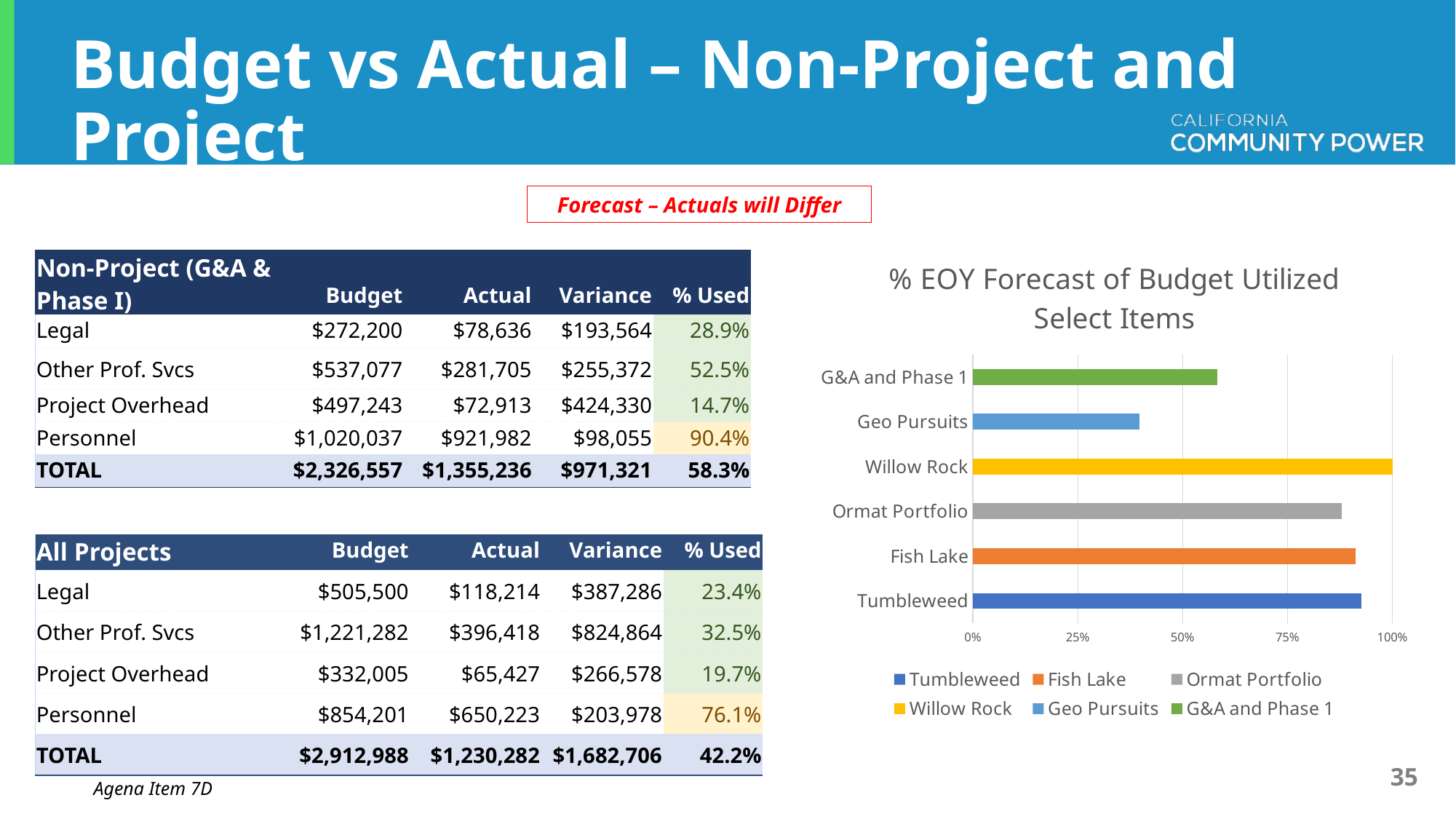
Which category has the lowest value in the chart? Geo Pursuits How many categories are plotted in the chart? 6 Which category has the highest value in the chart? Willow Rock How many entries does the chart's legend list? 6 Is the value for Geo Pursuits greater or less than 25%? greater Is the value for G&A and Phase 1 greater or less than 50%? greater Is the value for Geo Pursuits greater or less than 50%? less What colour is the bar for Willow Rock in the chart? yellow What kind of chart is shown on the slide? bar chart Which is larger in the chart, the value for G&A and Phase 1 or the value for Geo Pursuits? G&A and Phase 1 What is the title of the chart on the slide? % EOY Forecast of Budget Utilized Select Items